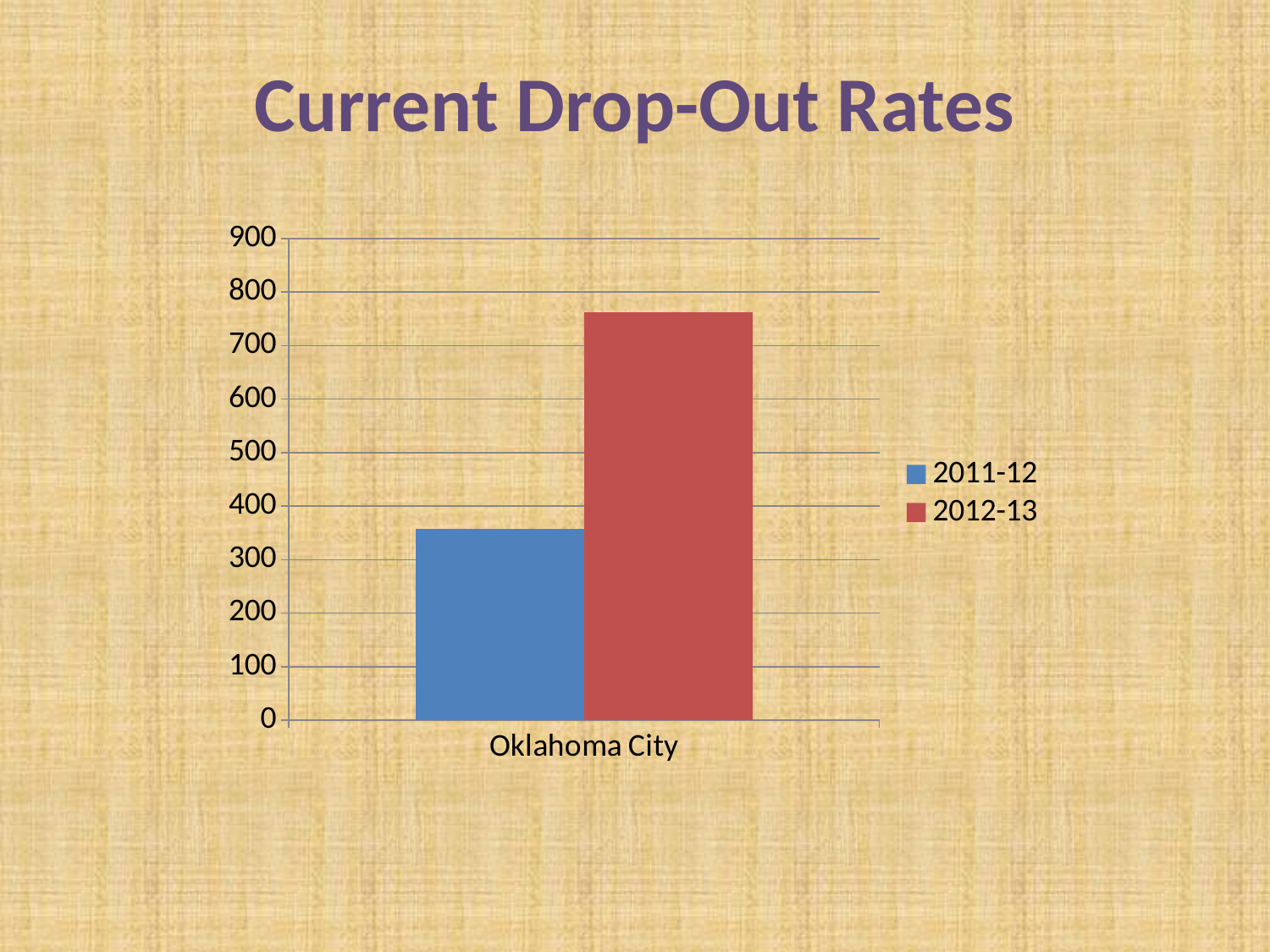
What kind of chart is shown on the slide? bar chart How many series does the legend list? 2 Is the value for 2012-13 in Oklahoma City greater or less than 800? less How many categories are shown on the x axis? 1 Is the value for 2012-13 in Oklahoma City greater or less than 700? greater Which series shows the lowest value for Oklahoma City? 2011-12 What is the title of the slide? Current Drop-Out Rates Which series has the higher value for Oklahoma City, 2011-12 or 2012-13? 2012-13 Is the value for 2011-12 in Oklahoma City greater or less than 400? less Which series is shown in red? 2012-13 What is the highest value shown on the vertical axis? 900